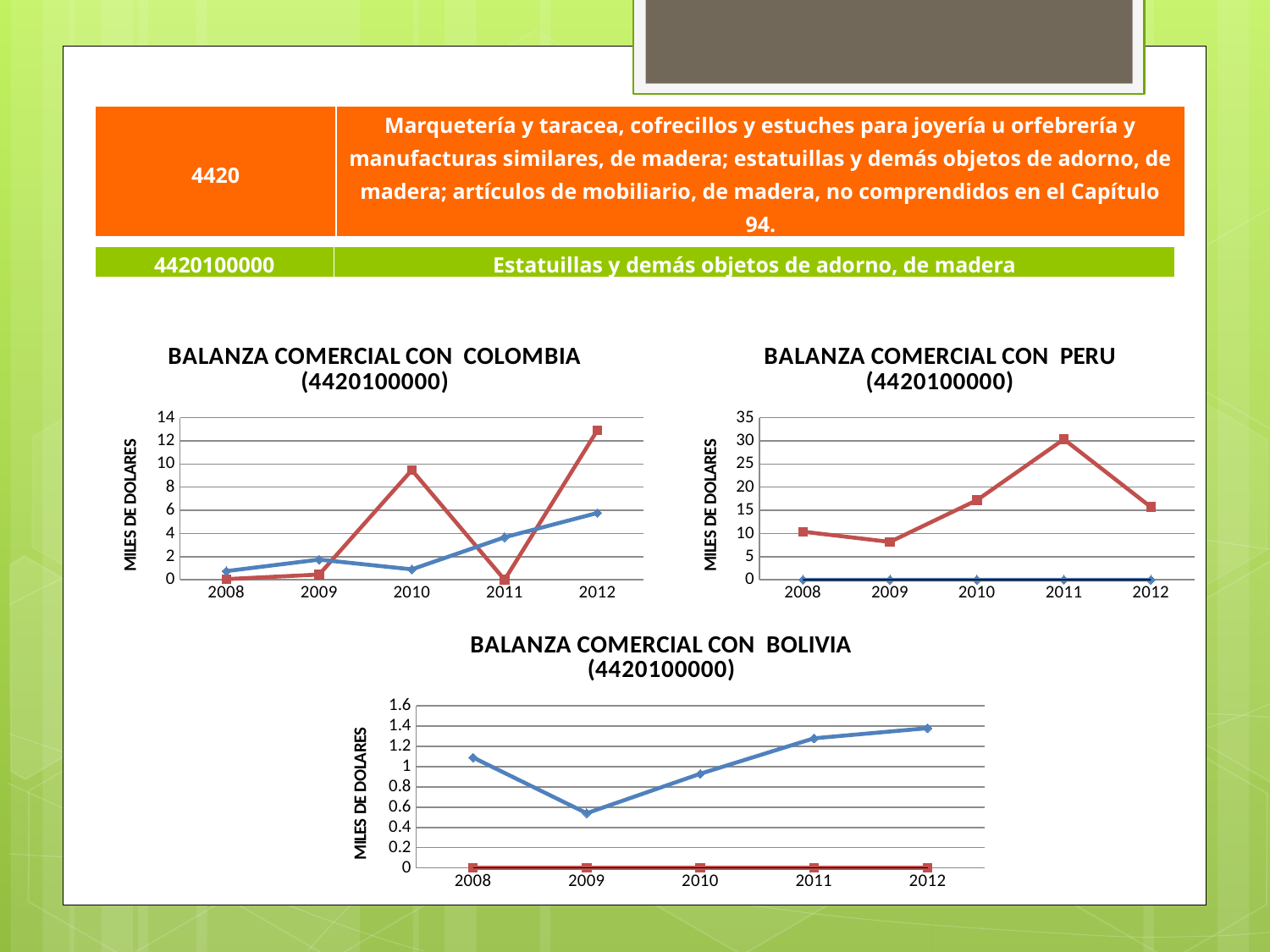
In the 'BALANZA COMERCIAL CON BOLIVIA (4420100000)' chart, in which year is the blue line at its lowest? 2009 In the 'BALANZA COMERCIAL CON PERU (4420100000)' chart, in which year does the red line reach its highest value? 2011 In the 'BALANZA COMERCIAL CON PERU (4420100000)' chart, is the red line's value for 2011 greater or less than 25? greater In the 'BALANZA COMERCIAL CON PERU (4420100000)' chart, is the red line's value for 2009 greater or less than 10? less In the 'BALANZA COMERCIAL CON BOLIVIA (4420100000)' chart, is the blue line's value for 2012 greater or less than 1.2? greater What is the y-axis label on the 'BALANZA COMERCIAL CON PERU (4420100000)' chart? MILES DE DOLARES In the 'BALANZA COMERCIAL CON COLOMBIA (4420100000)' chart, which line has the higher value in 2010, the red line or the blue line? the red line What kind of chart is the 'BALANZA COMERCIAL CON COLOMBIA (4420100000)' chart? line chart In the 'BALANZA COMERCIAL CON BOLIVIA (4420100000)' chart, does the blue line rise or fall from 2009 to 2012? rise In the 'BALANZA COMERCIAL CON COLOMBIA (4420100000)' chart, in which year does the red line reach its highest value? 2012 In the 'BALANZA COMERCIAL CON BOLIVIA (4420100000)' chart, how many years are shown on the x axis? 5